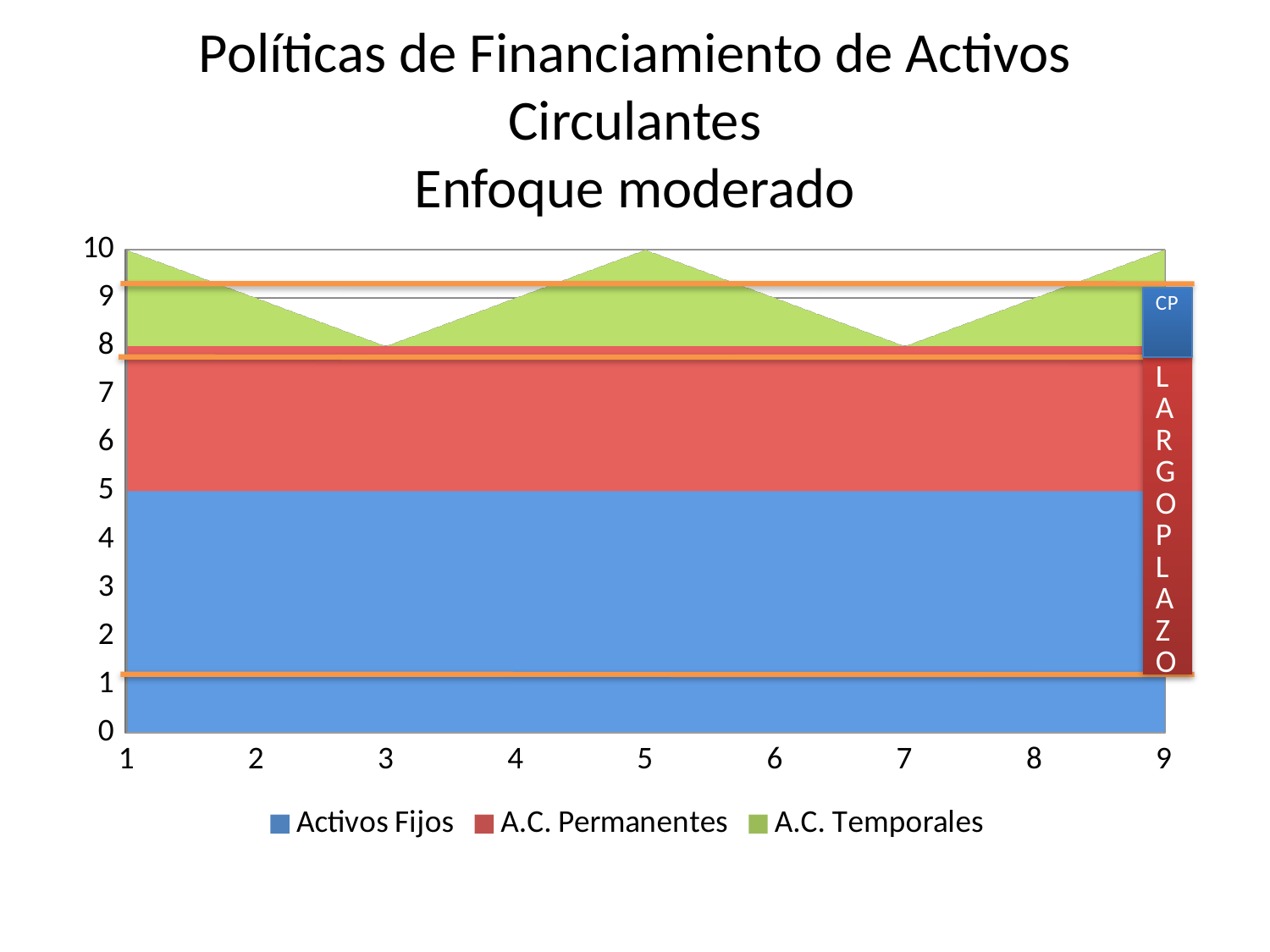
Does the Activos Fijos band rise, fall, or stay flat across the x axis? Stays flat What is the value of the Activos Fijos series at point 1? 5 Is the stacked total larger at point 5 or at point 7? Point 5 How many points are there along the x axis? 9 What kind of chart is shown on the slide? Stacked area chart Is the stacked total at point 5 greater or less than 9? greater What is the stacked total of all three series at point 1? 10 At what value does the top of the A.C. Permanentes band sit at point 4? 8 Is the stacked total at point 7 greater or less than 9? less What is the stacked total of all three series at point 3? 8 How many series does the legend list? 3 Which series is shown in green in the legend? A.C. Temporales